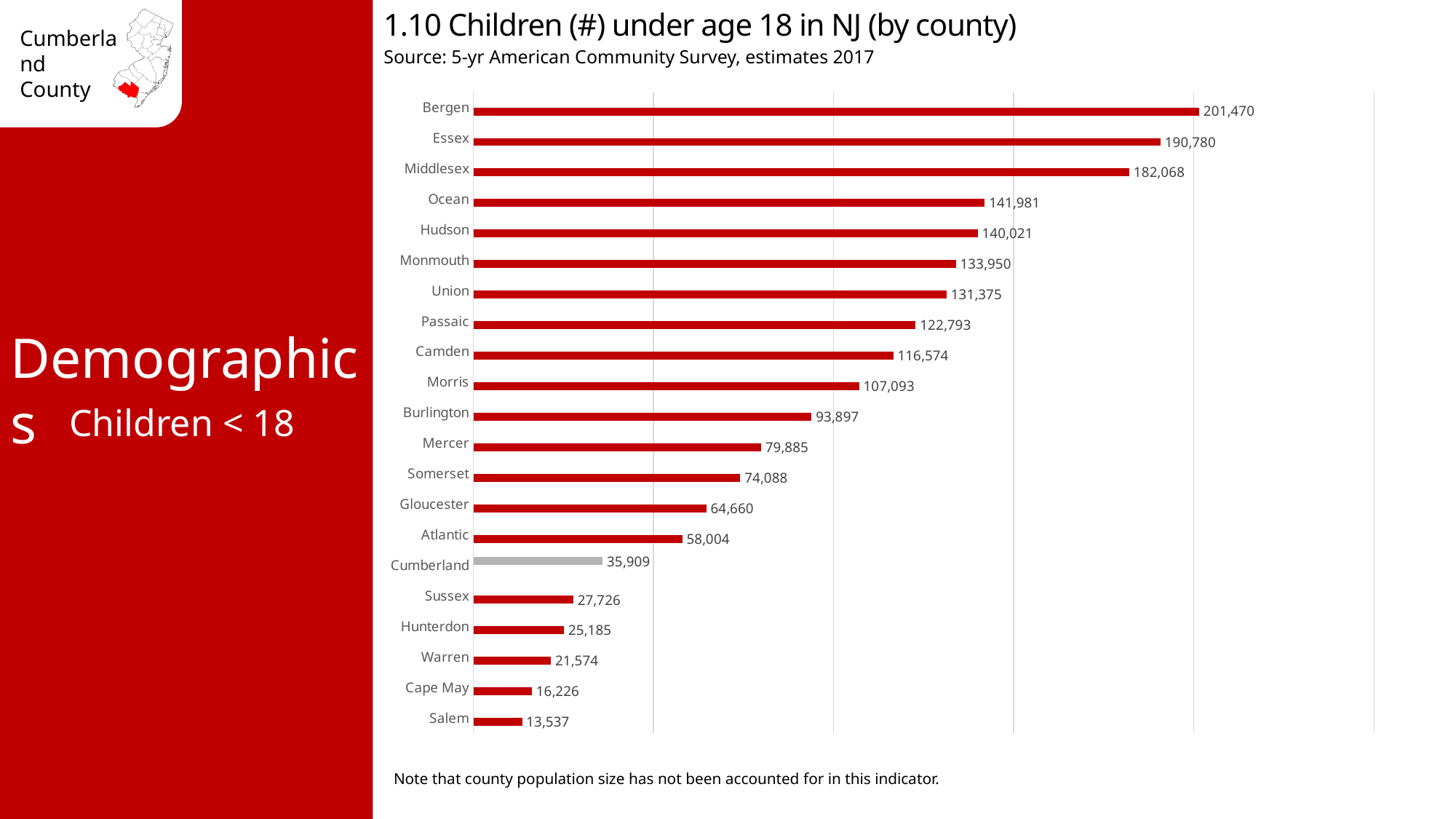
What is the difference between the values for Cumberland and Salem? 22,372 What is the number of children under age 18 in Cumberland County? 35,909 Which county has more children under 18, Camden or Morris? Camden How many counties are shown in the chart? 21 What is the difference between the values for Bergen and Essex? 10,690 Which county's bar is shown in grey instead of red? Cumberland What type of chart is used on this slide? Bar chart Which county has a larger value, Sussex or Warren? Sussex What is the value shown for Ocean County? 141,981 Which county has the lowest number of children under age 18? Salem How many children under 18 are shown for Gloucester County? 64,660 Which county has the highest number of children under age 18? Bergen